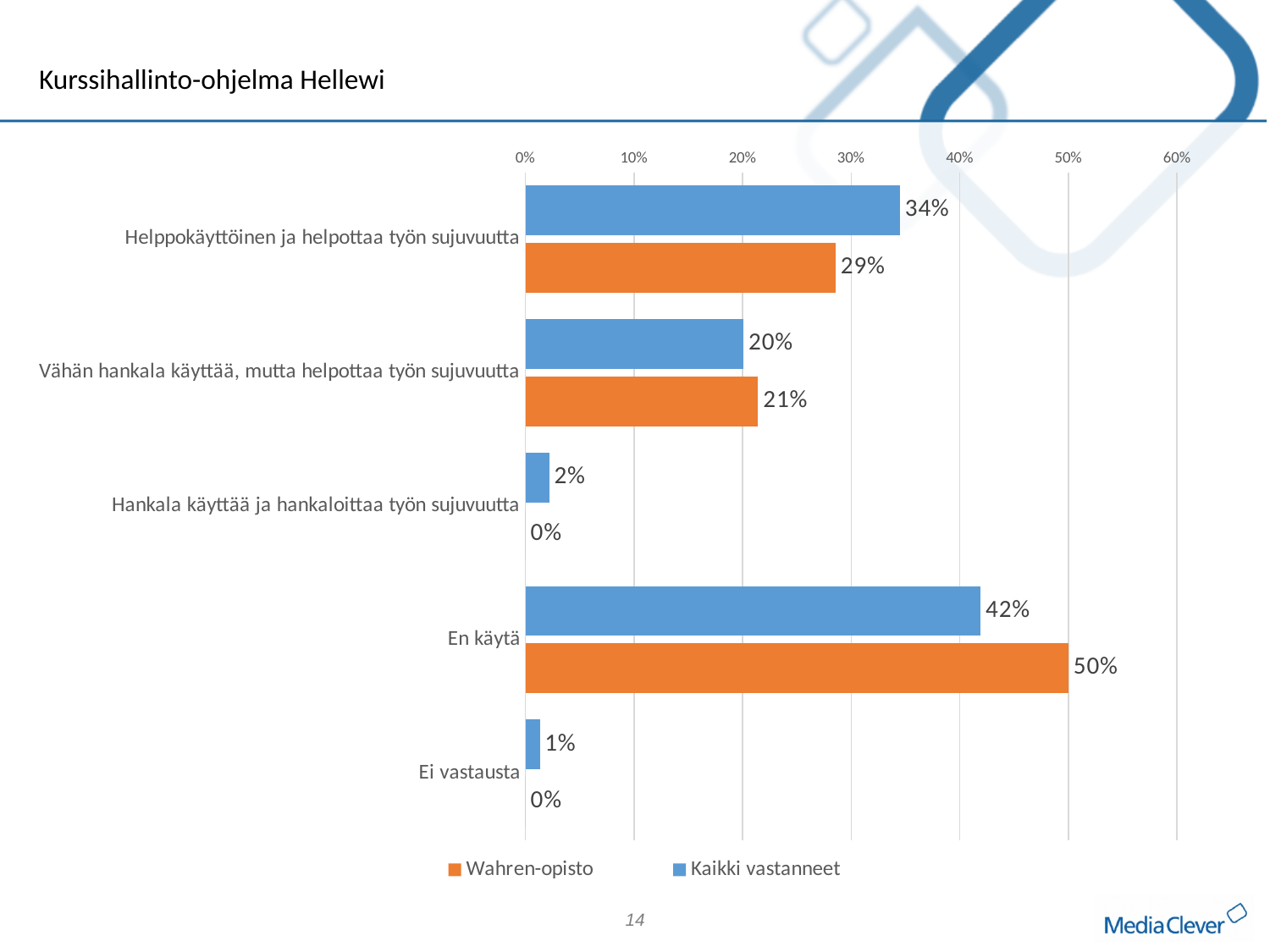
What is the difference between the Wahren-opisto and Kaikki vastanneet values for "En käytä"? 8% What kind of chart is shown on the slide? Bar chart Which category has the highest value for Wahren-opisto? En käytä What is the value for Wahren-opisto in the category "En käytä"? 50% Which category has the lowest value for Kaikki vastanneet? Ei vastausta For "Helppokäyttöinen ja helpottaa työn sujuvuutta", which series has the larger value, Wahren-opisto or Kaikki vastanneet? Kaikki vastanneet What is the value for Wahren-opisto in the category "Vähän hankala käyttää, mutta helpottaa työn sujuvuutta"? 21% What is the value for Kaikki vastanneet in the category "Helppokäyttöinen ja helpottaa työn sujuvuutta"? 34% What is the value for Kaikki vastanneet in the category "Ei vastausta"? 1% How many series does the legend list? 2 Which colour represents the Wahren-opisto series? Orange How many categories are shown on the chart? 5